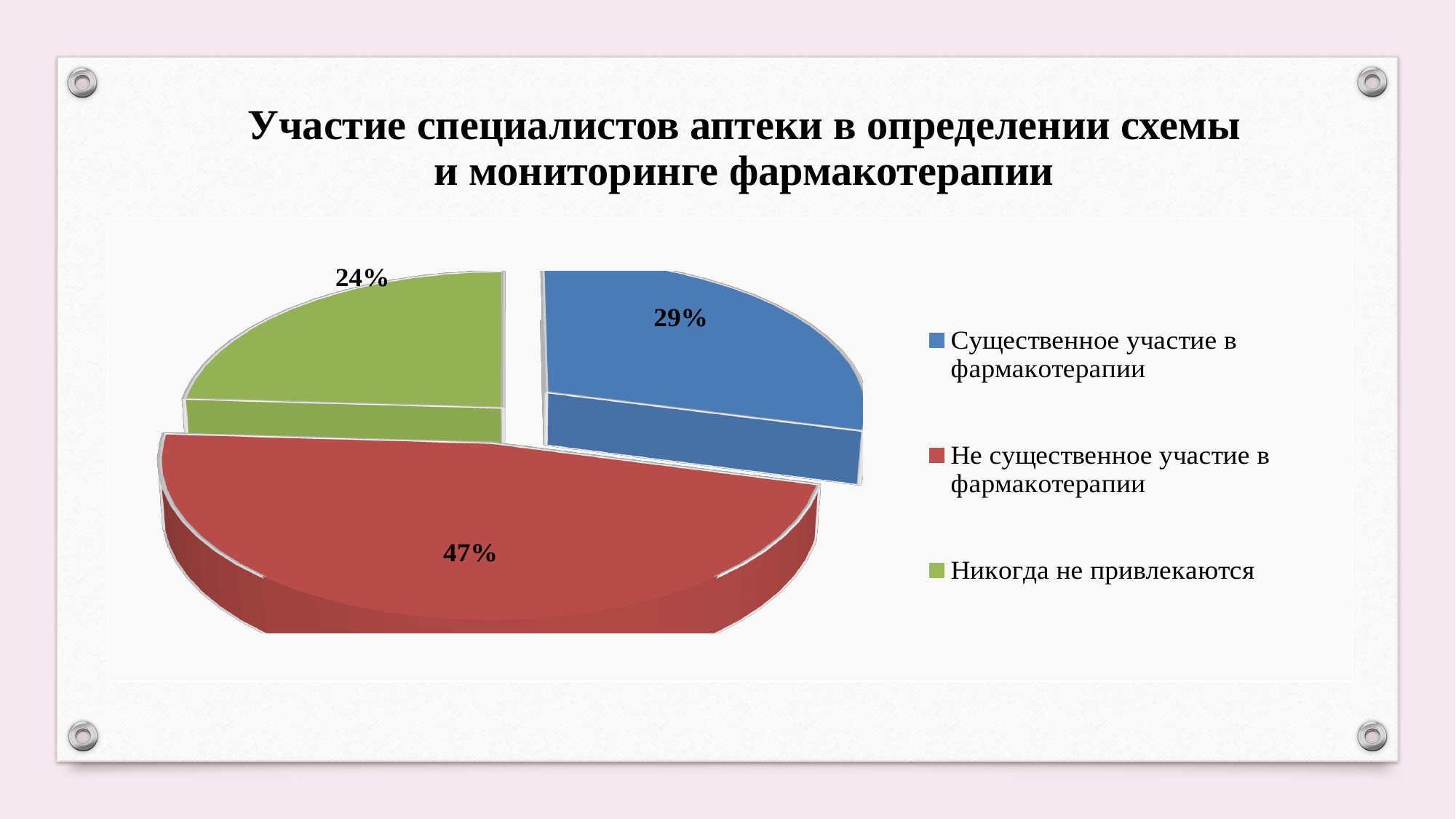
What is the title of the slide? Участие специалистов аптеки в определении схемы и мониторинге фармакотерапии What share of the pie is labelled "Существенное участие в фармакотерапии"? 29% What is the difference in percentage points between "Не существенное участие в фармакотерапии" and "Существенное участие в фармакотерапии"? 18 Which is larger: the slice for "Существенное участие в фармакотерапии" or the slice for "Никогда не привлекаются"? Существенное участие в фармакотерапии Which category has the largest slice of the pie? Не существенное участие в фармакотерапии What colour is the slice for "Никогда не привлекаются"? green What share of the pie is labelled "Не существенное участие в фармакотерапии"? 47% What share of the pie is labelled "Никогда не привлекаются"? 24% How many slices does the pie chart have? 3 What is the difference in percentage points between "Существенное участие в фармакотерапии" and "Никогда не привлекаются"? 5 What type of chart is shown on the slide? pie chart Which category has the smallest slice of the pie? Никогда не привлекаются